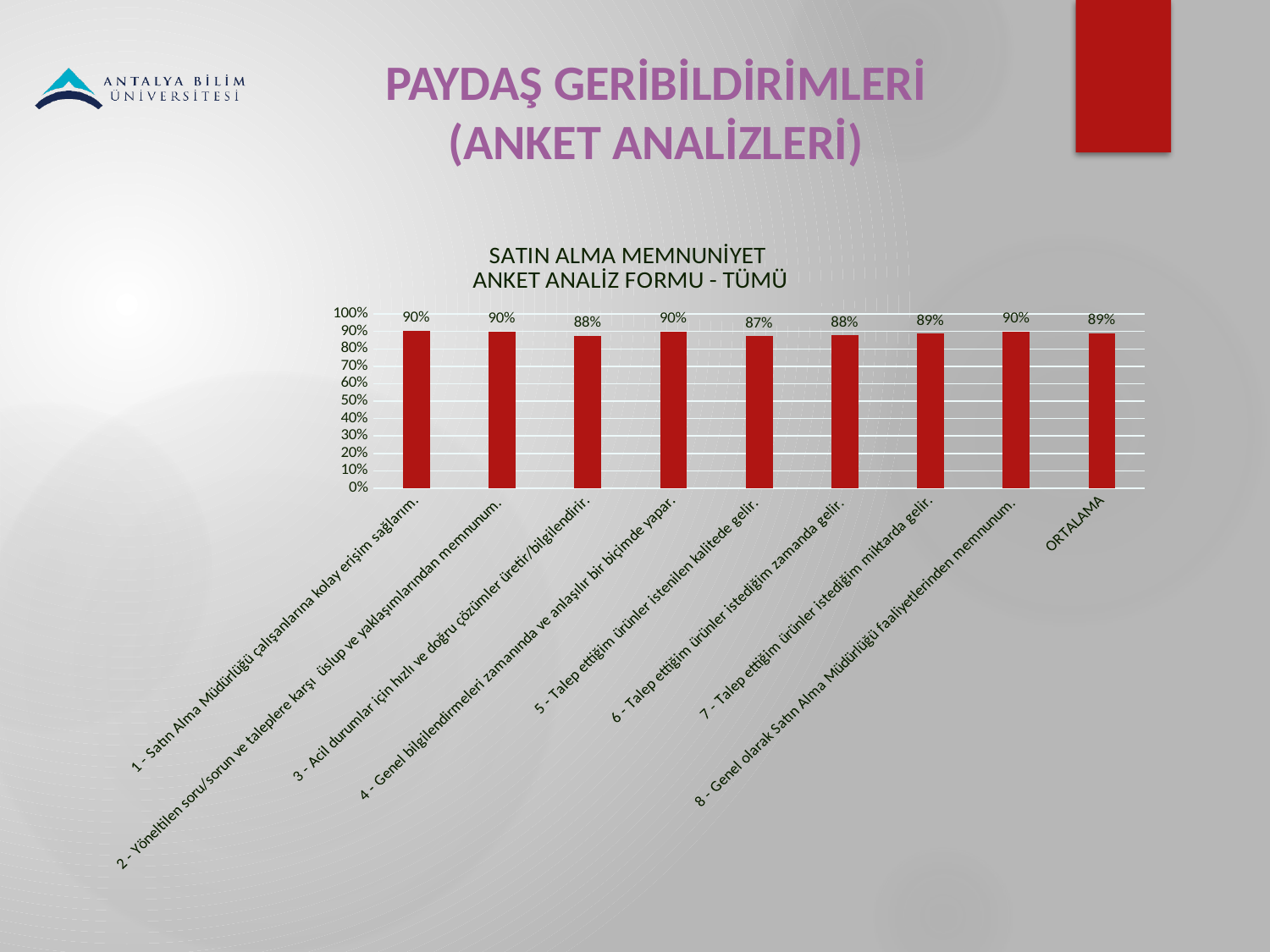
Is the value for item 4 greater or less than 80%? greater What kind of chart is shown on the slide? Bar chart Which category has the lowest value? 5 - Talep ettiğim ürünler istenilen kalitede gelir. What colour are the bars in the chart? Red What is the title of the chart? SATIN ALMA MEMNUNİYET ANKET ANALİZ FORMU - TÜMÜ What is the value for item 5 (Talep ettiğim ürünler istenilen kalitede gelir)? 87% Which is larger, the value for item 2 or the value for item 6? Item 2 What is the value for ORTALAMA? 89% What is the difference between the value for item 1 and the value for item 5? 3 percentage points What is the value for item 7 (Talep ettiğim ürünler istediğim miktarda gelir)? 89% How many bars are plotted in the chart? 9 What is the value for item 3 (Acil durumlar için hızlı ve doğru çözümler üretir/bilgilendirir)? 88%